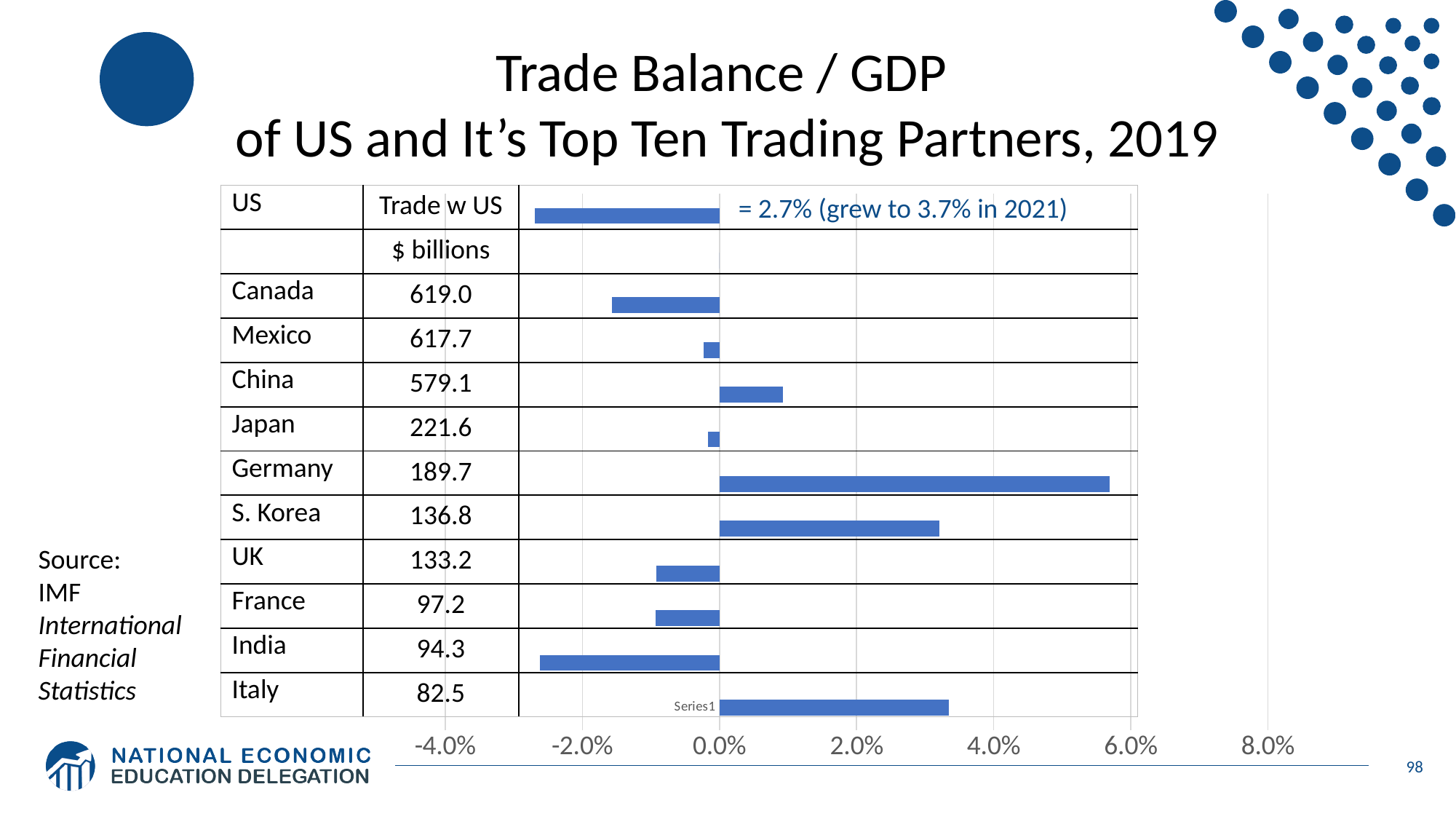
Is the trade balance / GDP value for Germany greater or less than 4.0%? greater How many bars (countries including the US) are plotted in the chart? 11 Is the trade balance / GDP value for Canada greater or less than -1.0%? less What kind of chart is shown on the slide? bar chart What is the highest value shown on the chart's x axis? 8.0% What 2019 value does the annotation next to the US bar give? 2.7% What is the source cited for the chart's data? IMF International Financial Statistics Which country has the highest trade balance / GDP in the chart? Germany Which has the larger trade balance / GDP, Germany or S. Korea? Germany Is the trade balance / GDP value for S. Korea greater or less than 2.0%? greater Which has the larger trade balance / GDP, China or Italy? Italy